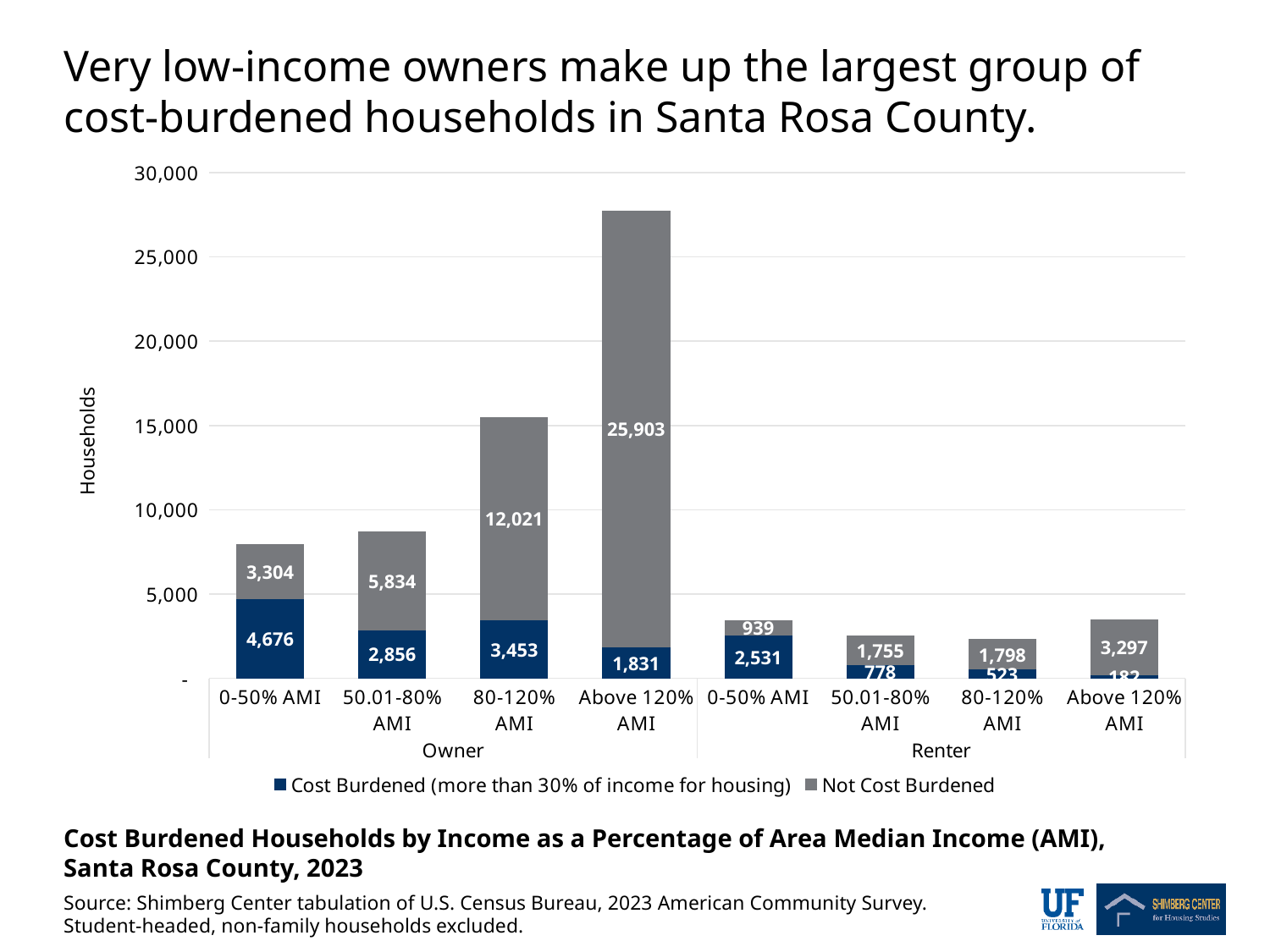
Which category has the smallest number of cost-burdened households? Renter, Above 120% AMI How many series does the legend list? 2 How many cost-burdened renter households are there at 0-50% AMI? 2,531 Is the total height of the Owner Above 120% AMI bar greater or less than 25,000? greater Which category has the largest number of cost-burdened households? Owner, 0-50% AMI How many cost-burdened households are there among owners at 0-50% AMI? 4,676 What is the Not Cost Burdened value for owners above 120% AMI? 25,903 What is the total number of households in the Owner 0-50% AMI bar? 7,980 Which is larger: the Not Cost Burdened value for owners at 80-120% AMI or for owners at 50.01-80% AMI? Owners at 80-120% AMI How many income categories are plotted across the Owner and Renter groups combined? 8 What type of chart is shown on the slide? Stacked bar chart What is the difference between the cost-burdened owner households at 0-50% AMI and at 50.01-80% AMI? 1,820